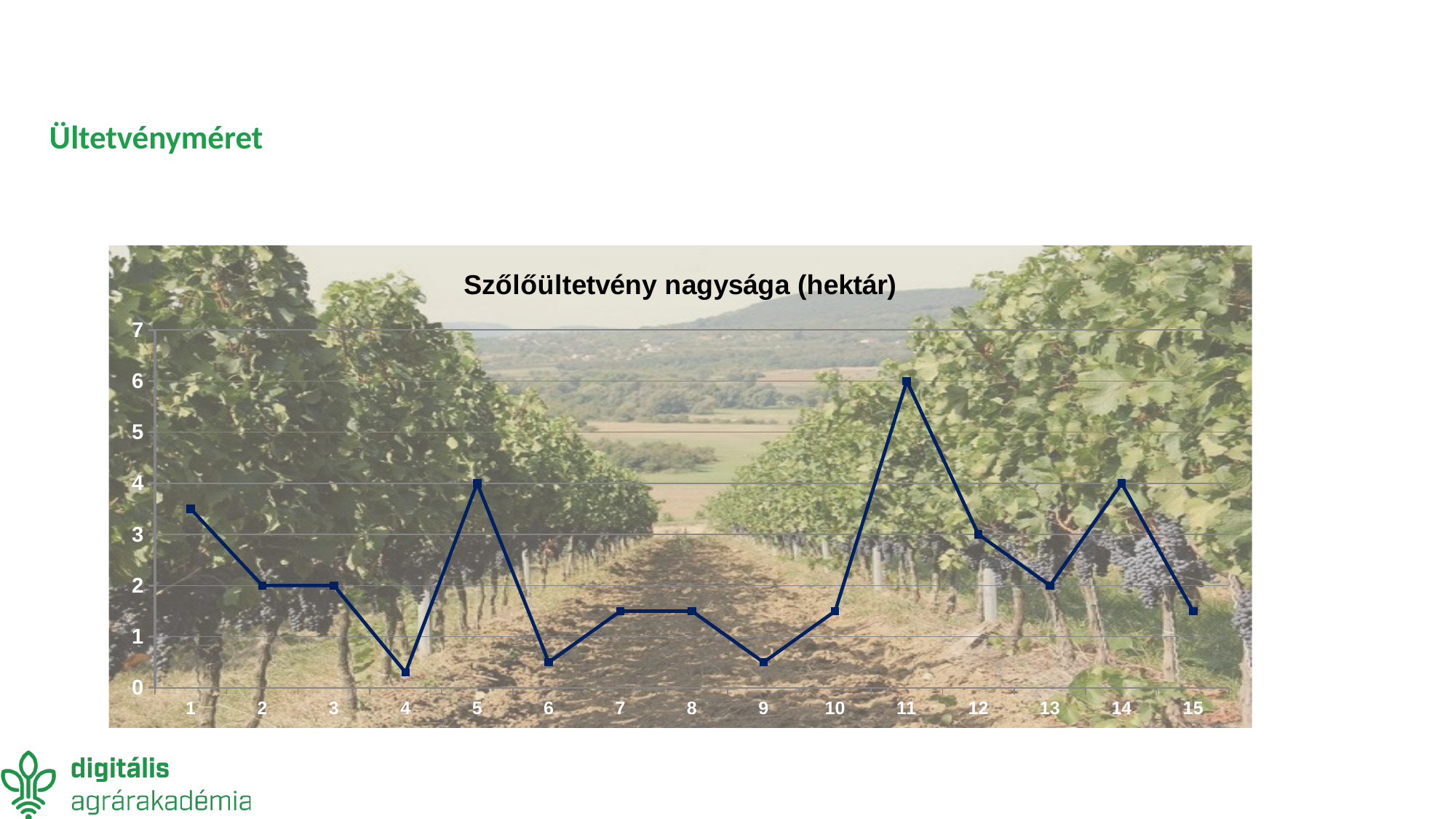
What is the difference between the values at point 11 and point 5? 2 Which point on the x axis has the highest value? 11 What is the value at point 5? 4 What is the value at point 12? 3 Is the value at point 9 greater or less than 1? less What is the title of the chart? Szőlőültetvény nagysága (hektár) What is the value at point 13? 2 Is the value at point 1 greater or less than 3? greater What is the value at point 11? 6 What kind of chart is shown on the slide? line chart Which is larger, the value at point 5 or the value at point 12? point 5 How many data points are plotted on the chart? 15